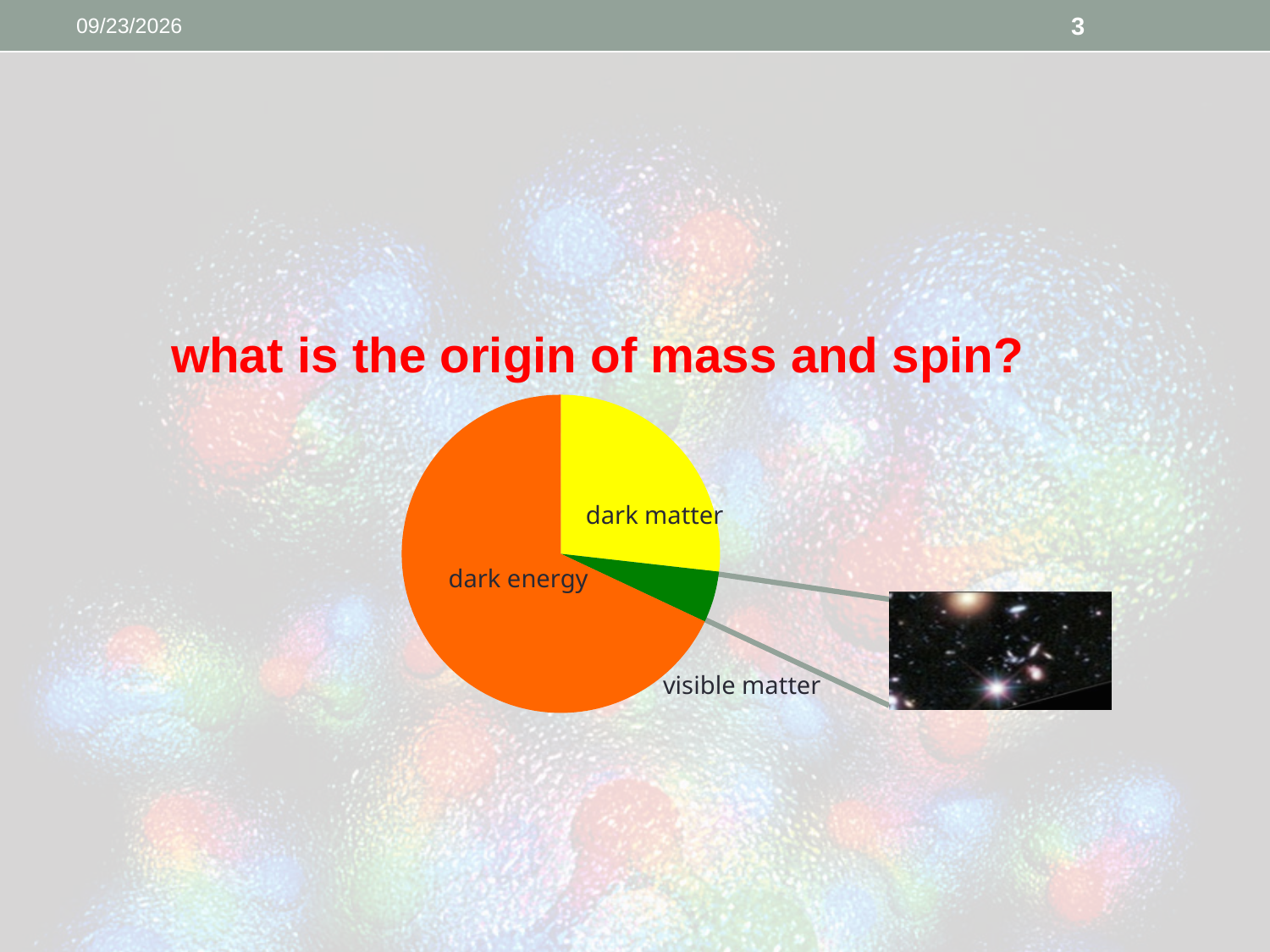
Does the dark energy slice take up more or less than half of the pie chart? more What kind of chart is shown on the slide? pie chart Which slice is larger in the pie chart, dark matter or visible matter? dark matter Which slice of the pie chart is coloured green? visible matter Which slice of the pie chart is the largest? dark energy What colour is the dark energy slice in the pie chart? orange How many slices does the pie chart have? 3 Which slice is larger in the pie chart, dark energy or dark matter? dark energy Which slice of the pie chart is the smallest? visible matter